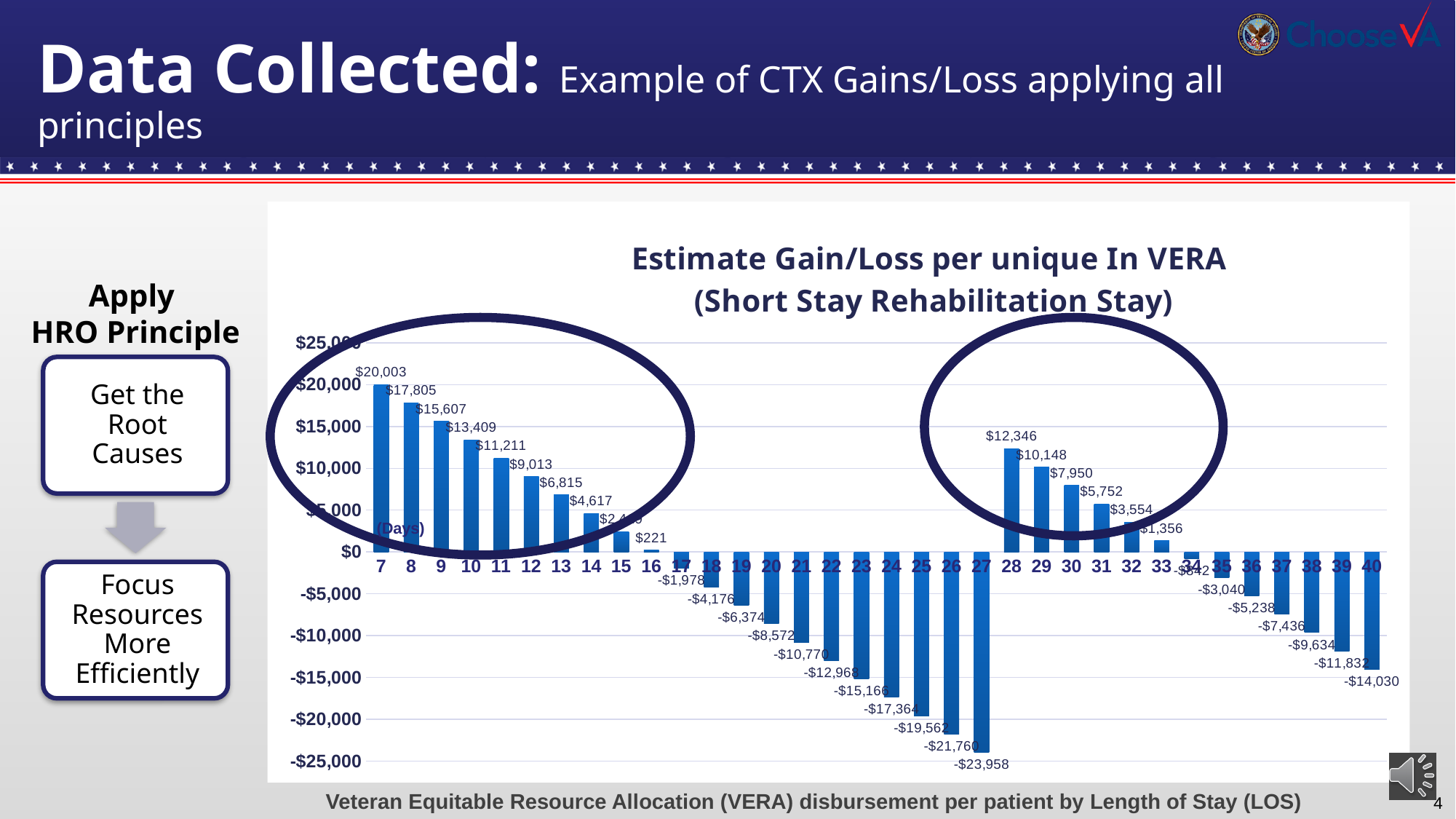
What is the estimated gain/loss value for day 28? $12,346 Do the values rise or fall from day 7 to day 27? Fall What is the estimated gain/loss value for day 40? -$14,030 Is the value for day 15 greater or less than $5,000? less What is the estimated gain/loss value for day 7? $20,003 How many days (categories) are plotted on the x axis? 34 Which day has the highest estimated gain/loss value? 7 Which day has the lowest estimated gain/loss value? 27 What kind of chart is shown on the slide? Bar chart Which has the larger value, day 28 or day 11? Day 28 What is the estimated gain/loss value for day 27? -$23,958 What is the difference between the values for day 7 and day 8? $2,198